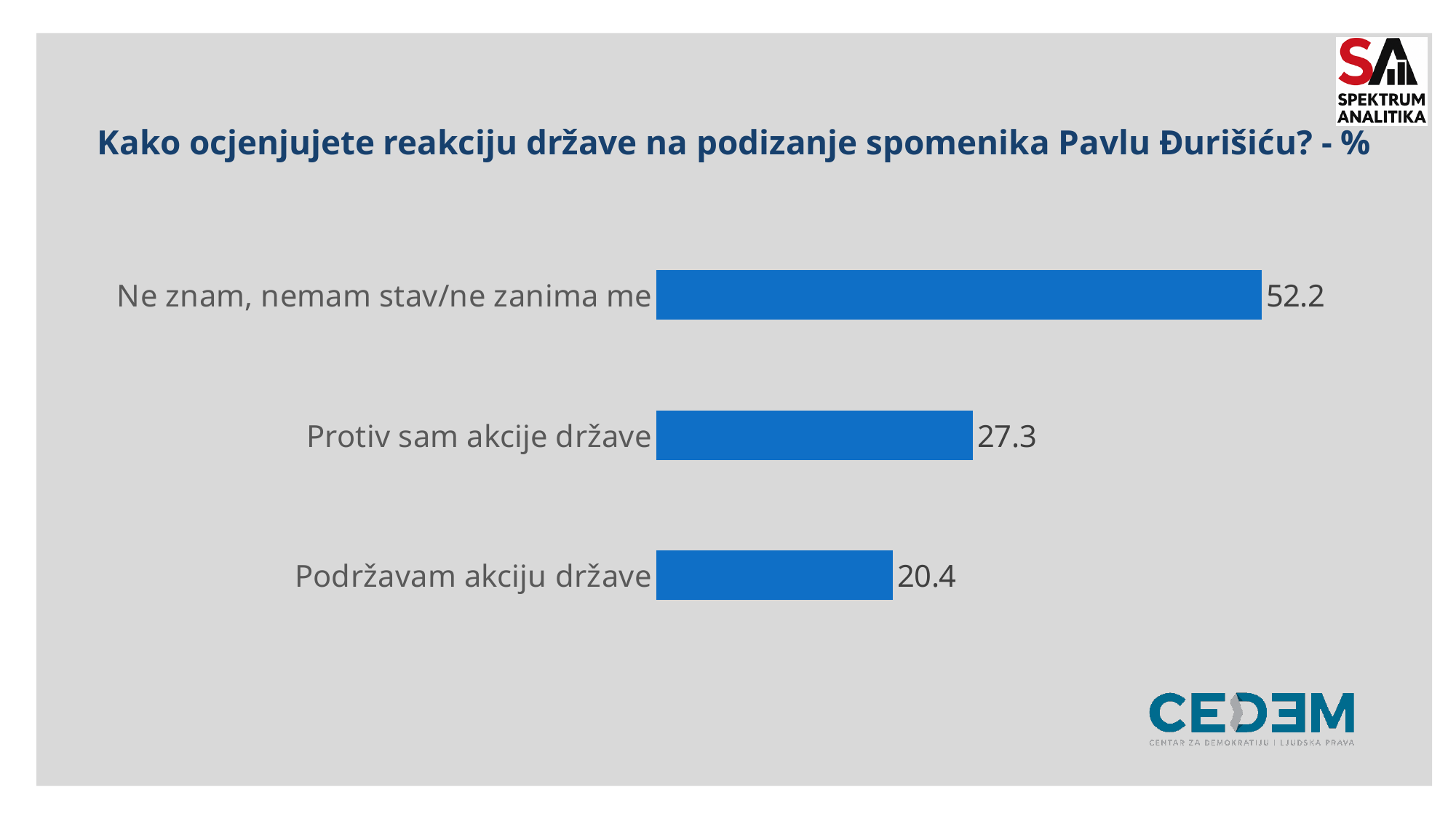
What is the value for "Protiv sam akcije države"? 27.3 What kind of chart is shown on the slide? Bar chart What is the difference between the values for "Ne znam, nemam stav/ne zanima me" and "Protiv sam akcije države"? 24.9 Which category has the lowest value? Podržavam akciju države What colour are the bars in the chart? Blue What is the value for "Podržavam akciju države"? 20.4 Which category has the highest value? Ne znam, nemam stav/ne zanima me Which is larger: the value for "Protiv sam akcije države" or "Podržavam akciju države"? Protiv sam akcije države How many categories are shown in the chart? 3 What is the value for "Ne znam, nemam stav/ne zanima me"? 52.2 What is the title of the chart? Kako ocjenjujete reakciju države na podizanje spomenika Pavlu Đurišiću? - % What is the difference between the values for "Protiv sam akcije države" and "Podržavam akciju države"? 6.9